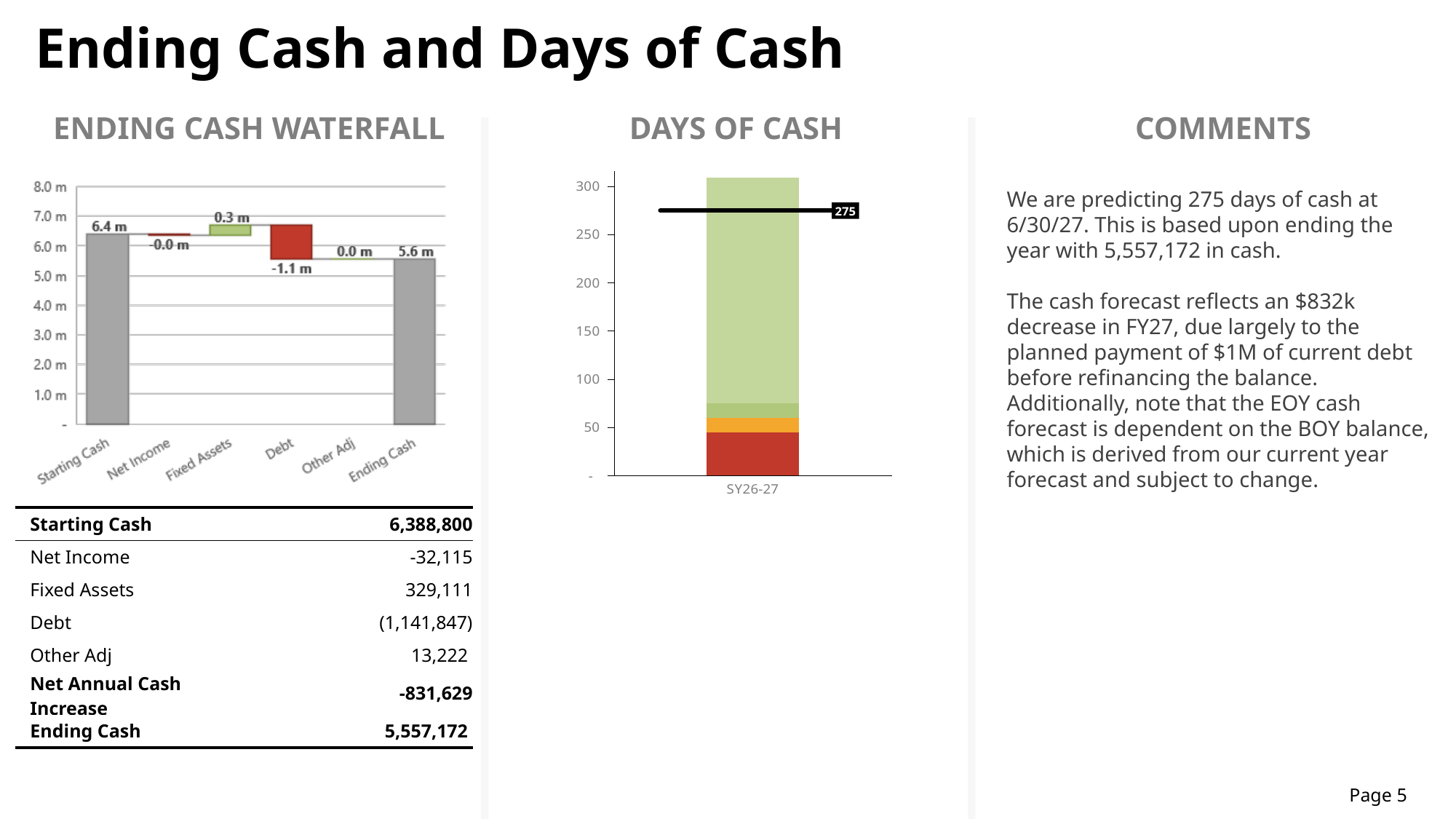
In the Ending Cash Waterfall chart, what is the difference between Starting Cash (6.4 m) and Ending Cash (5.6 m)? 0.8 m In the Ending Cash Waterfall chart, what is the value shown for Debt? -1.1 m In the Ending Cash Waterfall chart, what is the value shown for Fixed Assets? 0.3 m In the Ending Cash Waterfall chart, what is the value shown for Ending Cash? 5.6 m In the Days of Cash chart, is the red bottom segment greater or less than 50? less In the Days of Cash chart, is the total height of the stacked bar greater or less than 300? greater In the Days of Cash chart, what value is labelled on the horizontal marker line? 275 How many categories are shown on the x axis of the Ending Cash Waterfall chart? 6 In the Ending Cash Waterfall chart, which adjustment category shows the largest decrease? Debt In the Ending Cash Waterfall chart, which is larger, Starting Cash or Ending Cash? Starting Cash What is the x-axis category label in the Days of Cash chart? SY26-27 In the Ending Cash Waterfall chart, what is the value shown for Starting Cash? 6.4 m